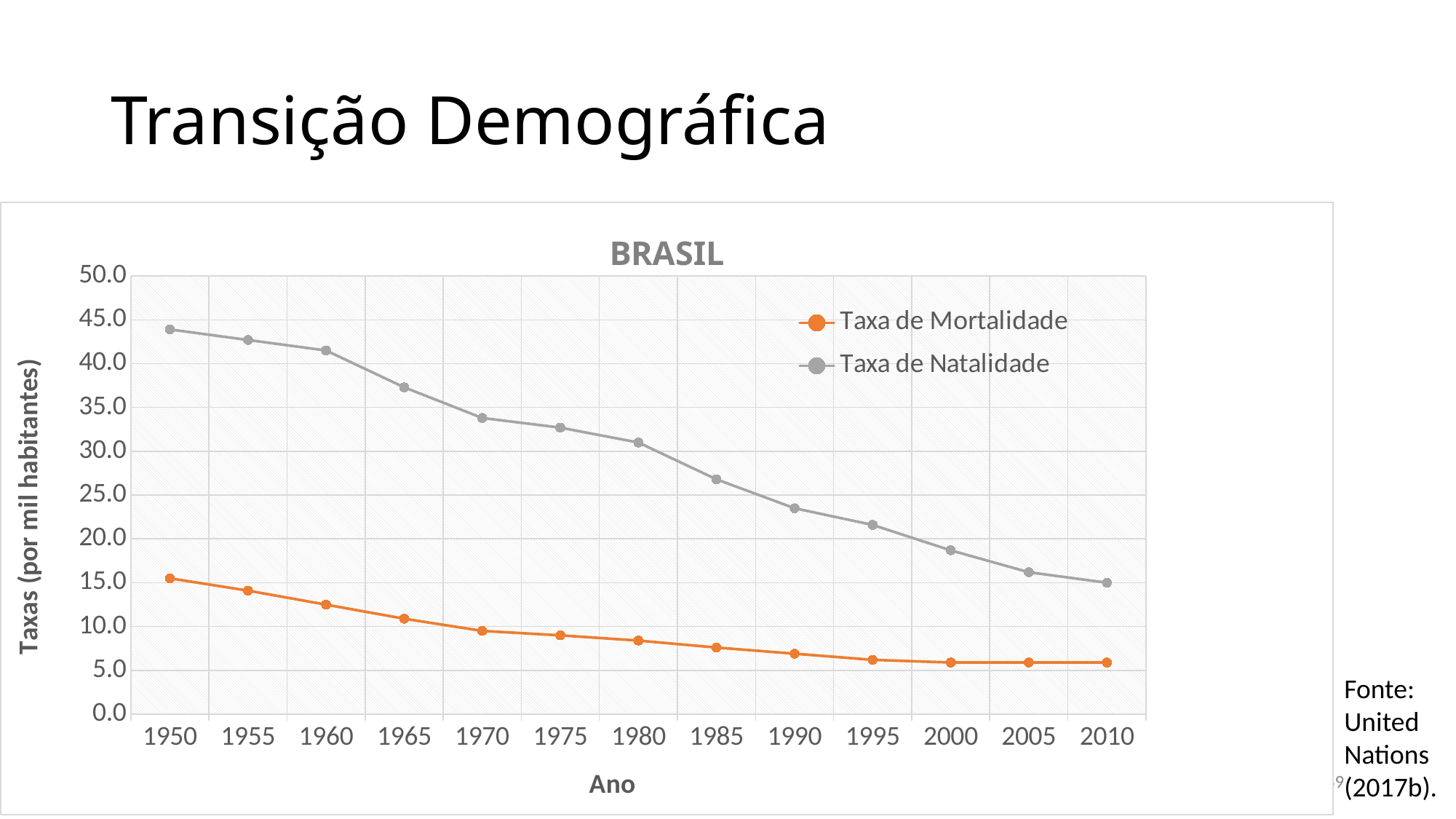
How many years are plotted along the x axis? 13 What kind of chart is shown on the slide? line chart What is the title of the chart? BRASIL In which year is Taxa de Natalidade lowest? 2010 In which year is Taxa de Natalidade highest? 1950 Is the value for Taxa de Natalidade in 1950 greater or less than 40.0? greater Do the values for Taxa de Mortalidade rise or fall from 1950 to 2010? fall How many series does the legend list? 2 In which year is Taxa de Mortalidade highest? 1950 Which series has the larger value in 1980, Taxa de Mortalidade or Taxa de Natalidade? Taxa de Natalidade Do the values for Taxa de Natalidade rise or fall from 1950 to 2010? fall Is the value for Taxa de Mortalidade in 2010 greater or less than 10.0? less